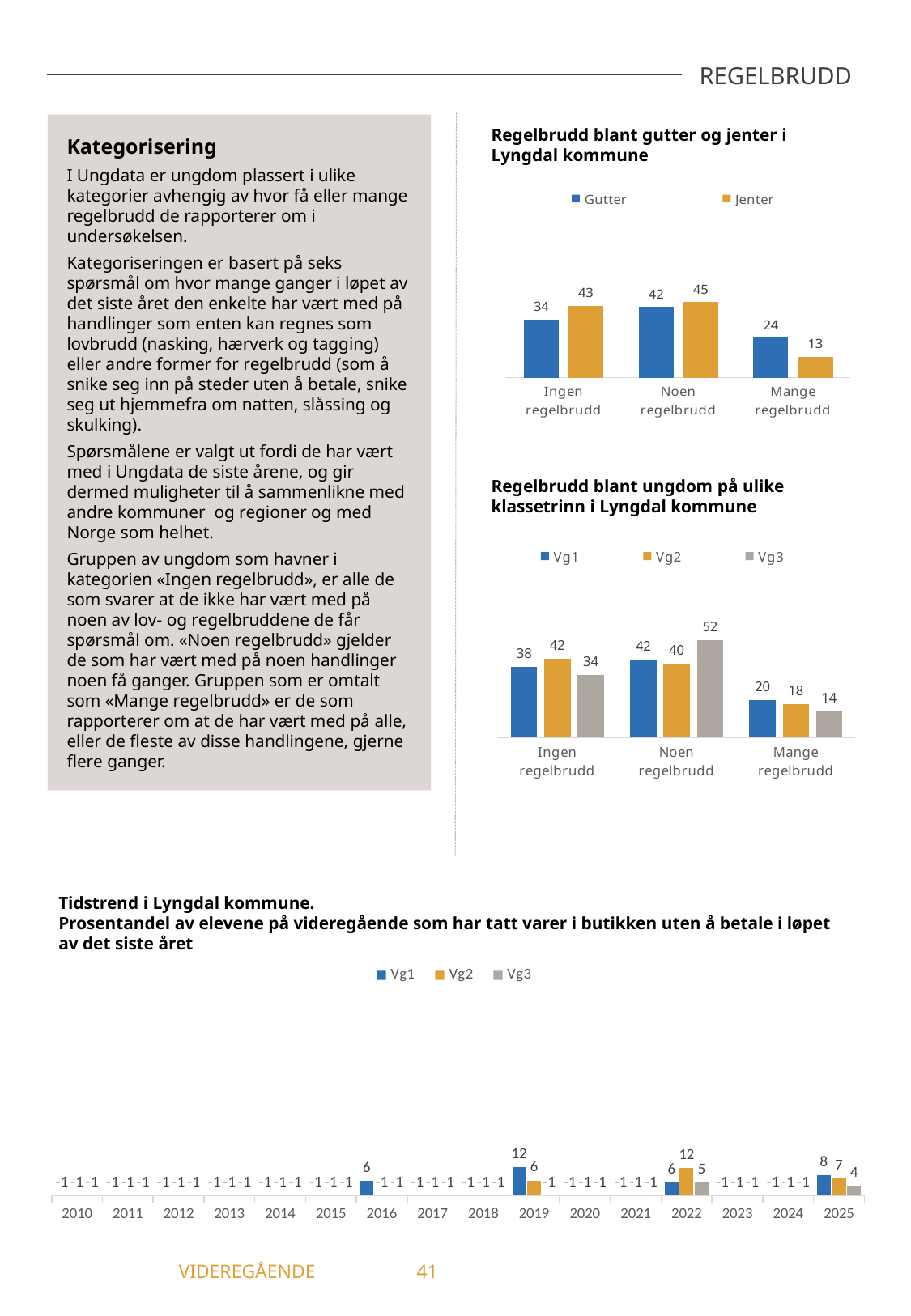
How many series does the legend list in the chart 'Regelbrudd blant gutter og jenter i Lyngdal kommune'? 2 In the chart 'Regelbrudd blant ungdom på ulike klassetrinn i Lyngdal kommune', what is the difference between Vg1 and Vg3 in the 'Ingen regelbrudd' category? 4 In the chart 'Regelbrudd blant ungdom på ulike klassetrinn i Lyngdal kommune', what is the value for Vg3 in the 'Noen regelbrudd' category? 52 In the chart 'Tidstrend i Lyngdal kommune', what is the value for Vg2 in 2022? 12 In the chart 'Regelbrudd blant gutter og jenter i Lyngdal kommune', what is the value for Jenter in the 'Ingen regelbrudd' category? 43 In the chart 'Regelbrudd blant ungdom på ulike klassetrinn i Lyngdal kommune', which category has the lowest value for Vg2? Mange regelbrudd How many categories are shown on the x axis of the chart 'Regelbrudd blant ungdom på ulike klassetrinn i Lyngdal kommune'? 3 What kind of chart is 'Tidstrend i Lyngdal kommune'? Bar chart In the chart 'Regelbrudd blant gutter og jenter i Lyngdal kommune', what is the difference between Gutter and Jenter in the 'Mange regelbrudd' category? 11 In the chart 'Regelbrudd blant gutter og jenter i Lyngdal kommune', which is larger in the 'Noen regelbrudd' category, Gutter or Jenter? Jenter In the chart 'Regelbrudd blant gutter og jenter i Lyngdal kommune', which category has the highest value for Gutter? Noen regelbrudd In the chart 'Tidstrend i Lyngdal kommune', which is larger in 2025, Vg1 or Vg3? Vg1